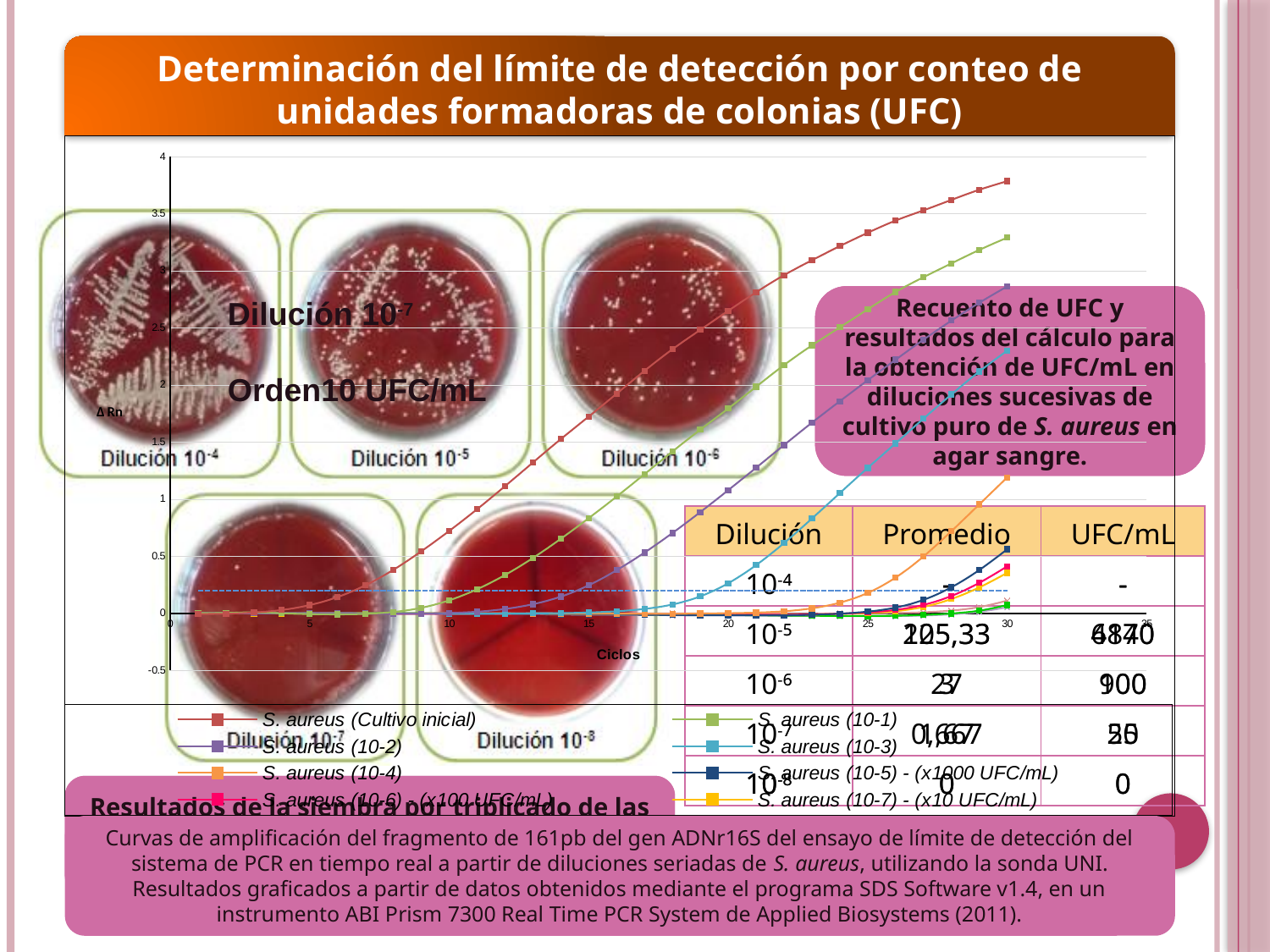
At cycle 30, which series has the larger value: S. aureus (10-2) or S. aureus (10-4)? S. aureus (10-2) What is the label of the y axis of the chart? Δ Rn At cycle 30, is the value for S. aureus (Cultivo inicial) greater or less than 3.5? greater At cycle 30, is the value for S. aureus (10-3) greater or less than 1? greater At cycle 30, is the value for S. aureus (10-1) greater or less than 2.5? greater Which series reaches the highest Δ Rn value at the end of the curves? S. aureus (Cultivo inicial) Do the amplification curves rise or fall as the number of cycles increases? rise What kind of chart is shown on the slide? line chart What is the label of the x axis of the chart? Ciclos At cycle 30, which series has the larger value: S. aureus (Cultivo inicial) or S. aureus (10-1)? S. aureus (Cultivo inicial)